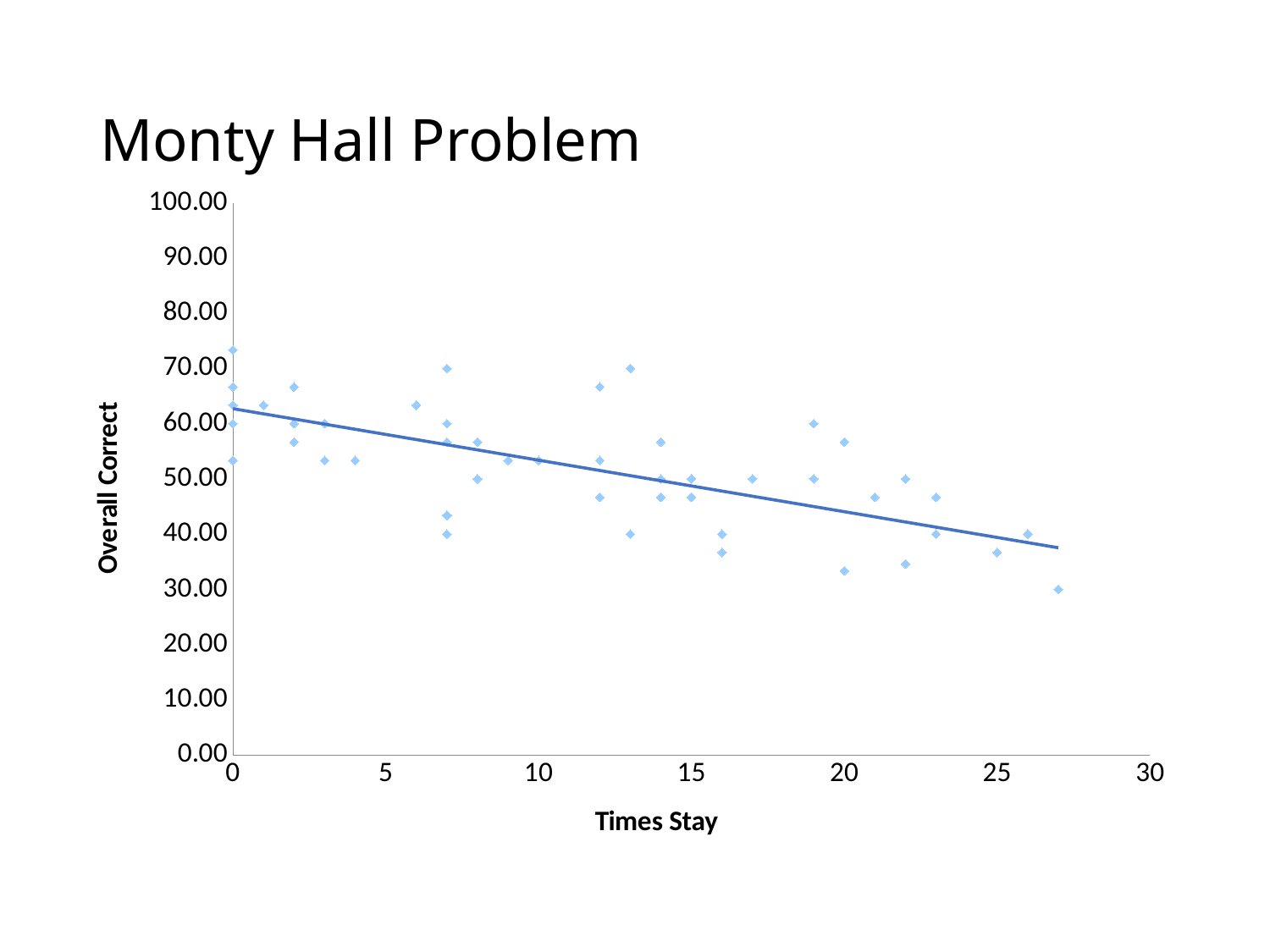
Do the values of Overall Correct generally rise or fall as Times Stay increases? Fall Is the plotted point at Times Stay = 27 greater or less than 40? less Is the plotted point at Times Stay = 25 greater or less than 40? less Is the value of the trend line at Times Stay = 0 greater or less than 60? greater What kind of chart is shown on the slide? Scatter chart What is the title of the vertical axis? Overall Correct What is the title of the horizontal axis? Times Stay Is the plotted point at Times Stay = 27 higher or lower than the plotted point at Times Stay = 6? lower